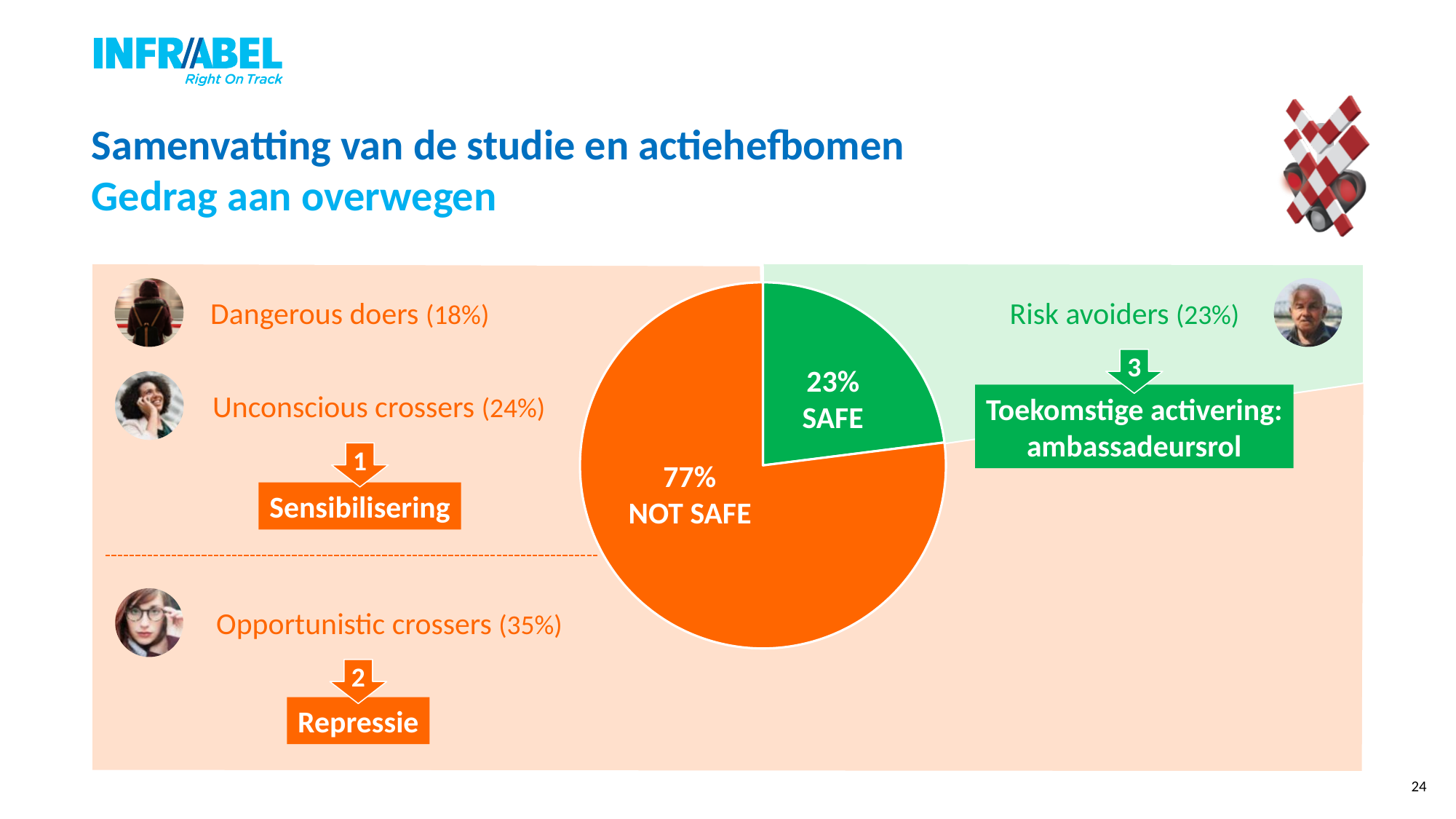
Which is larger, the SAFE slice or the NOT SAFE slice? NOT SAFE Is the NOT SAFE share greater or less than 50%? greater What is the difference in percentage points between the NOT SAFE slice and the SAFE slice? 54 What is the total of the two pie slices? 100% What colour is the NOT SAFE slice of the pie? orange What kind of chart is shown on the slide? pie chart What share of the pie is labelled SAFE? 23% What share of the pie is labelled NOT SAFE? 77% Which slice of the pie is the smallest? SAFE Which slice of the pie is the largest? NOT SAFE How many slices does the pie chart have? 2 What colour is the SAFE slice of the pie? green